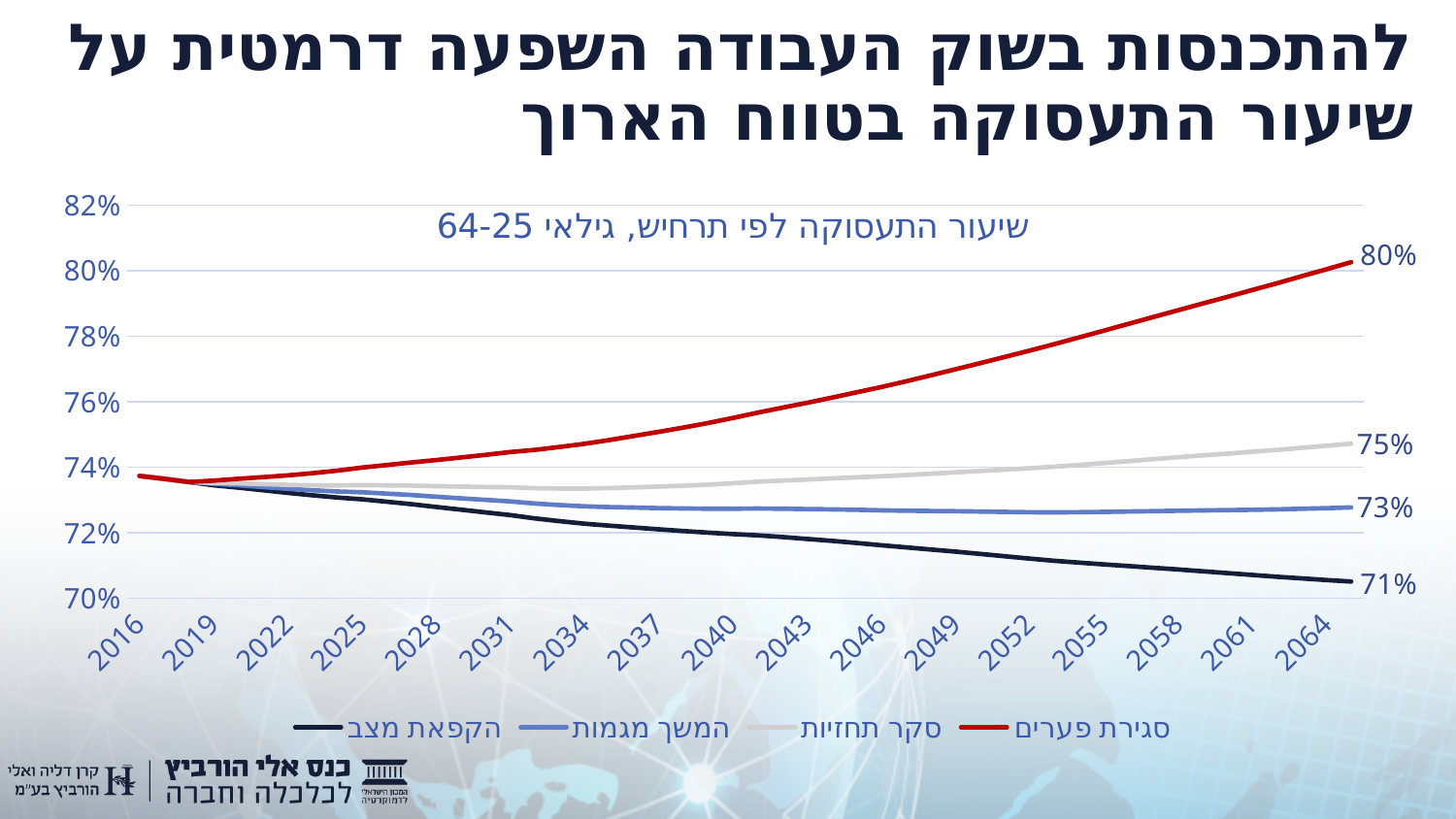
What is the final value (at 2064) of the סגירת פערים series? 80% Does the הקפאת מצב series rise or fall from 2016 to 2064? fall What is the final value (at 2064) of the סקר תחזיות series? 75% What kind of chart is shown on the slide? line chart Which series has the highest value at the end of the chart (2064)? סגירת פערים What is the title of the chart? שיעור התעסוקה לפי תרחיש, גילאי 64-25 Which series has the lowest value at the end of the chart (2064)? הקפאת מצב How many series does the legend list? 4 What is the final value (at 2064) of the המשך מגמות series? 73% Is the value of the סגירת פערים series in 2040 greater or less than 74%? greater What is the difference between the 2064 values of the סגירת פערים and הקפאת מצב series? 9 percentage points What is the final value (at 2064) of the הקפאת מצב series? 71%